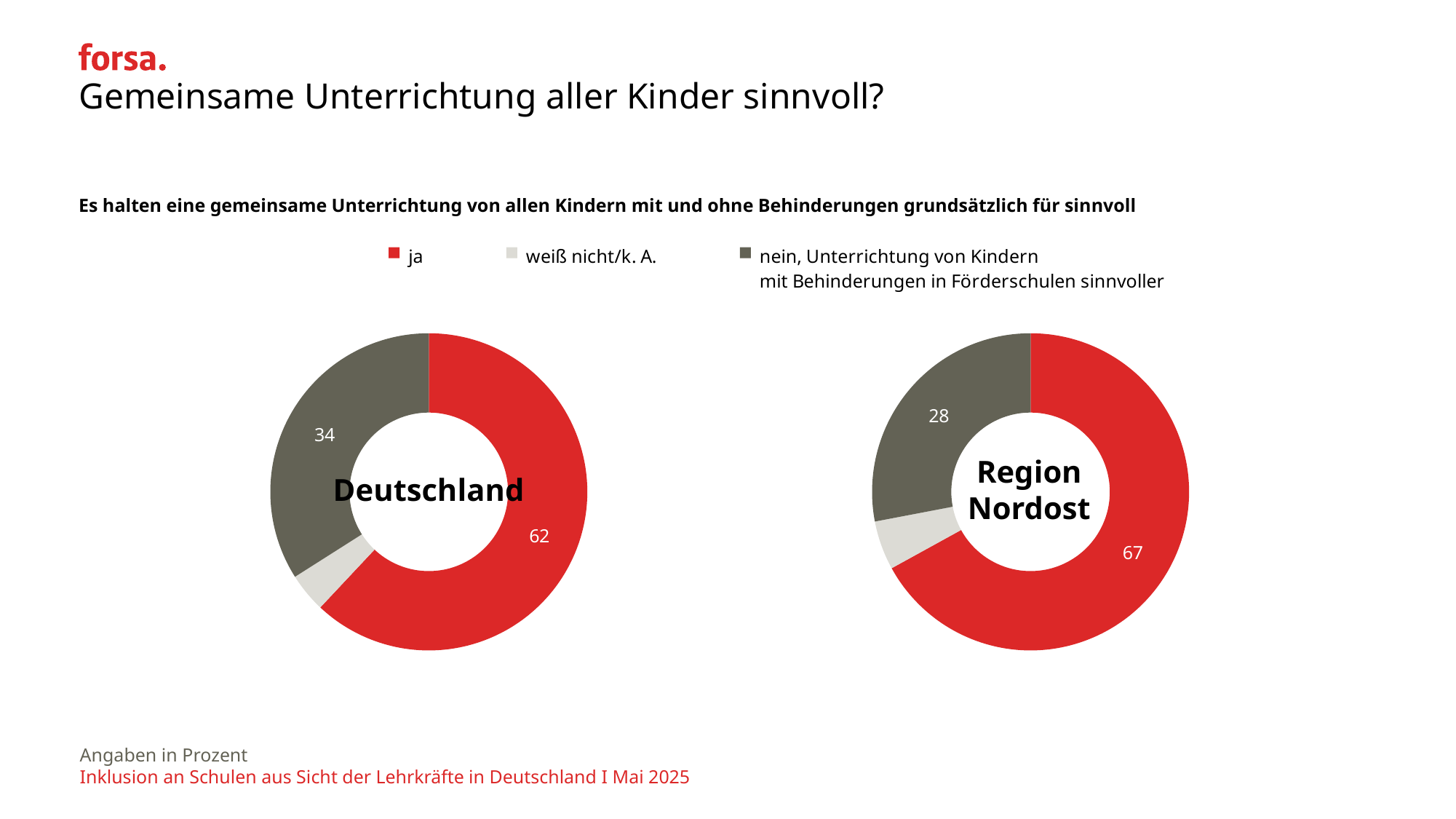
How many categories does each chart show? 3 In the Region Nordost chart, what is the value for "ja"? 67 In the Deutschland chart, what is the value for "nein, Unterrichtung von Kindern mit Behinderungen in Förderschulen sinnvoller"? 34 In the Deutschland chart, which category has the largest share? ja In the Deutschland chart, what is the value for "ja"? 62 In the Region Nordost chart, which category has the smallest share? weiß nicht/k. A. What is the difference between the "ja" value in the Region Nordost chart and the "ja" value in the Deutschland chart? 5 What kind of chart is used on this slide? Pie (donut) chart In the Region Nordost chart, what is the value for "nein, Unterrichtung von Kindern mit Behinderungen in Förderschulen sinnvoller"? 28 Is the "nein" value larger in the Deutschland chart or in the Region Nordost chart? Deutschland In the Deutschland chart, what is the difference between the values for "ja" and "nein"? 28 Which colour represents "ja" in the legend? Red